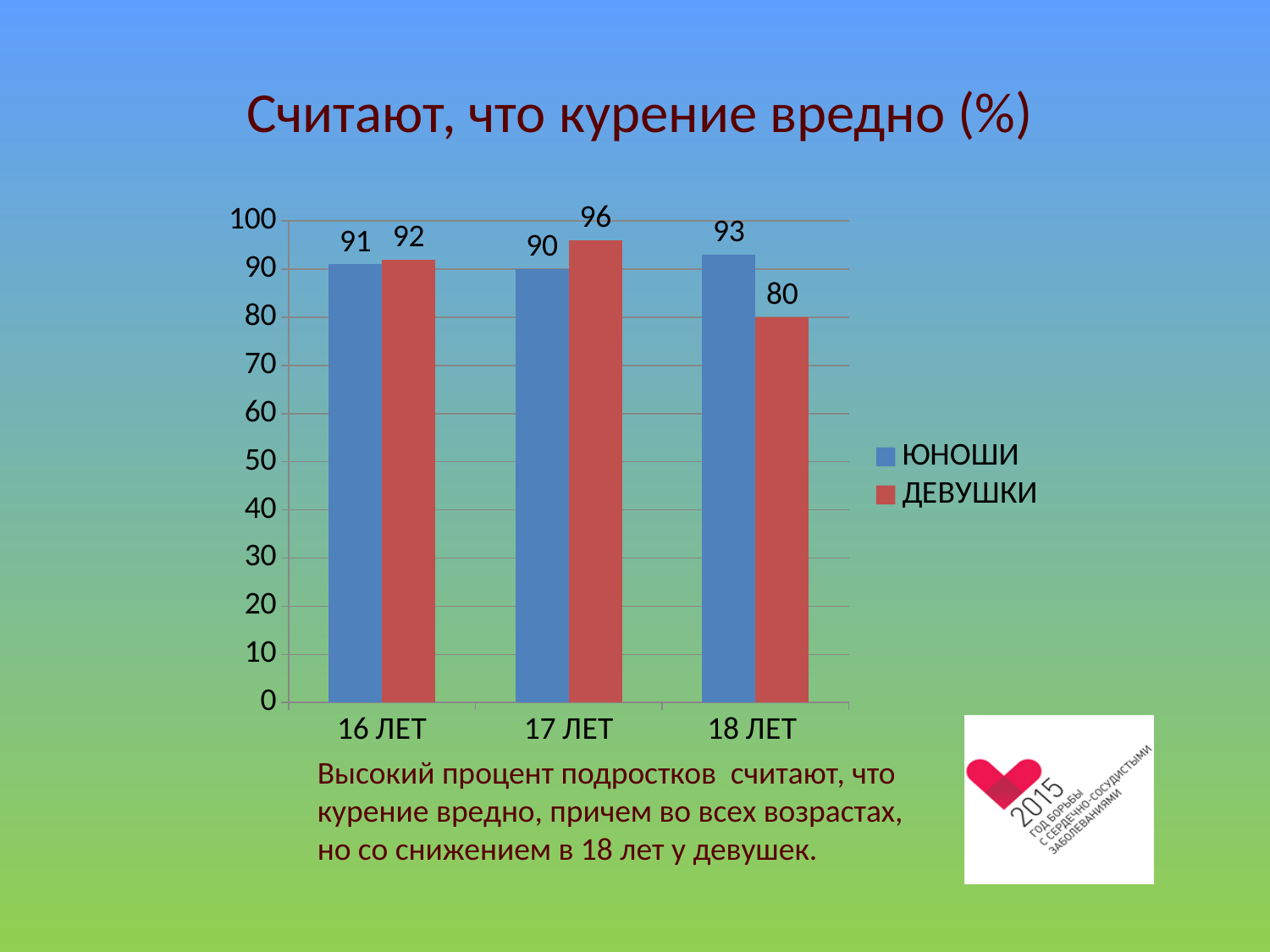
Which age group has the highest value for ДЕВУШКИ? 17 ЛЕТ What is the value for ЮНОШИ at 16 ЛЕТ? 91 How many age groups are shown on the x axis? 3 What is the value for ДЕВУШКИ at 17 ЛЕТ? 96 At 17 ЛЕТ, which is larger: ЮНОШИ or ДЕВУШКИ? ДЕВУШКИ Which age group has the lowest value for ЮНОШИ? 17 ЛЕТ What is the title of the chart? Считают, что курение вредно (%) What is the difference between ЮНОШИ and ДЕВУШКИ at 18 ЛЕТ? 13 What kind of chart is shown on the slide? bar chart Is the value for ДЕВУШКИ at 18 ЛЕТ greater or less than 90? less How many series does the legend list? 2 What is the value for ДЕВУШКИ at 18 ЛЕТ? 80